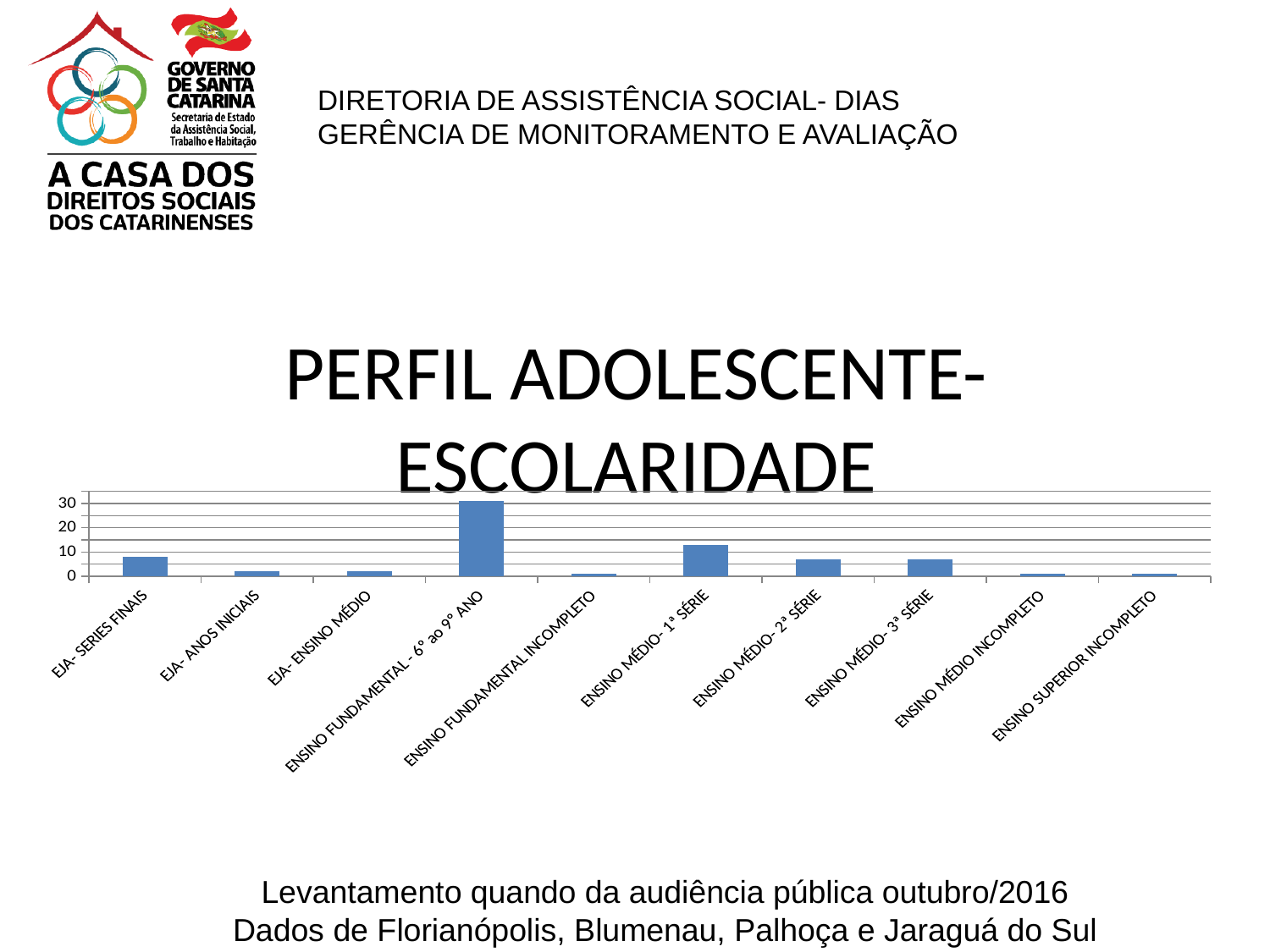
Which is larger, the value for ENSINO MÉDIO- 1ª SÉRIE or the value for EJA- SERIES FINAIS? ENSINO MÉDIO- 1ª SÉRIE Is the value for EJA- SERIES FINAIS greater or less than 10? less Which is larger, the value for ENSINO FUNDAMENTAL - 6° ao 9° ANO or the value for ENSINO MÉDIO- 1ª SÉRIE? ENSINO FUNDAMENTAL - 6° ao 9° ANO How many categories are shown on the x axis of the chart? 10 Is the value for ENSINO MÉDIO- 1ª SÉRIE greater or less than 10? greater Is the value for ENSINO FUNDAMENTAL - 6° ao 9° ANO greater or less than 20? greater Which category has the highest value in the chart? ENSINO FUNDAMENTAL - 6° ao 9° ANO What is the title of the chart? PERFIL ADOLESCENTE- ESCOLARIDADE What kind of chart is shown on the slide? Bar chart Which is larger, the value for EJA- SERIES FINAIS or the value for EJA- ANOS INICIAIS? EJA- SERIES FINAIS What is the highest tick value shown on the y axis of the chart? 30